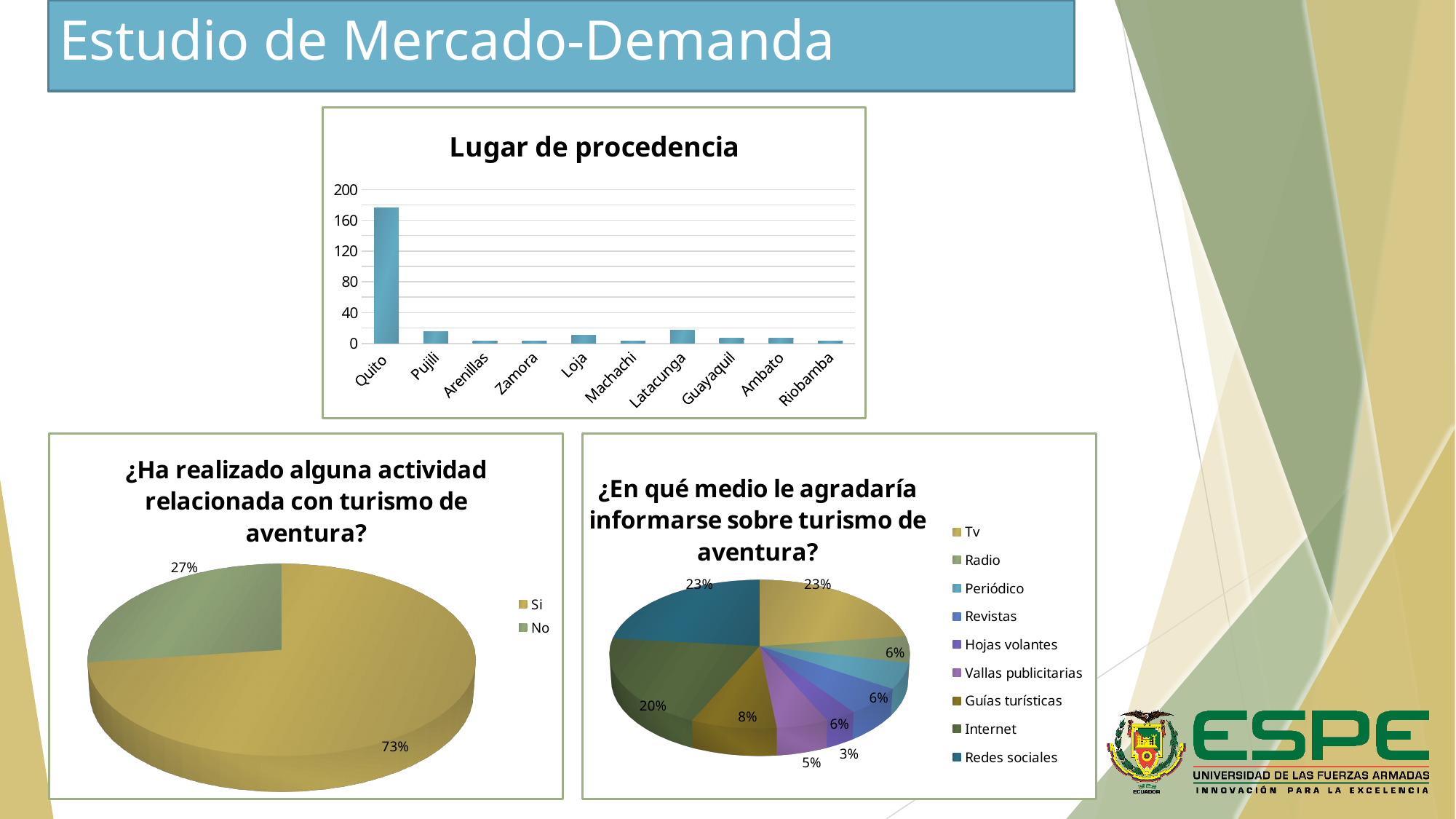
In the pie chart '¿En qué medio le agradaría informarse sobre turismo de aventura?', what share is 'Internet'? 20% In the 'Lugar de procedencia' chart, is the value for Pujili greater or less than 40? less What kind of chart is 'Lugar de procedencia'? bar chart How many entries does the legend of the pie chart '¿En qué medio le agradaría informarse sobre turismo de aventura?' list? 9 In the pie chart '¿Ha realizado alguna actividad relacionada con turismo de aventura?', what share is 'Si'? 73% In the pie chart '¿En qué medio le agradaría informarse sobre turismo de aventura?', which is larger, 'Guías turísticas' or 'Hojas volantes'? Guías turísticas In the 'Lugar de procedencia' chart, which place has the highest value? Quito In the pie chart '¿En qué medio le agradaría informarse sobre turismo de aventura?', which medium has the smallest share? Hojas volantes In the 'Lugar de procedencia' chart, is the value for Quito greater or less than 160? greater In the pie chart '¿Ha realizado alguna actividad relacionada con turismo de aventura?', what is the difference between the 'Si' and 'No' shares? 46% How many places are shown on the x axis of the 'Lugar de procedencia' chart? 10 How many entries does the legend of the pie chart '¿Ha realizado alguna actividad relacionada con turismo de aventura?' list? 2